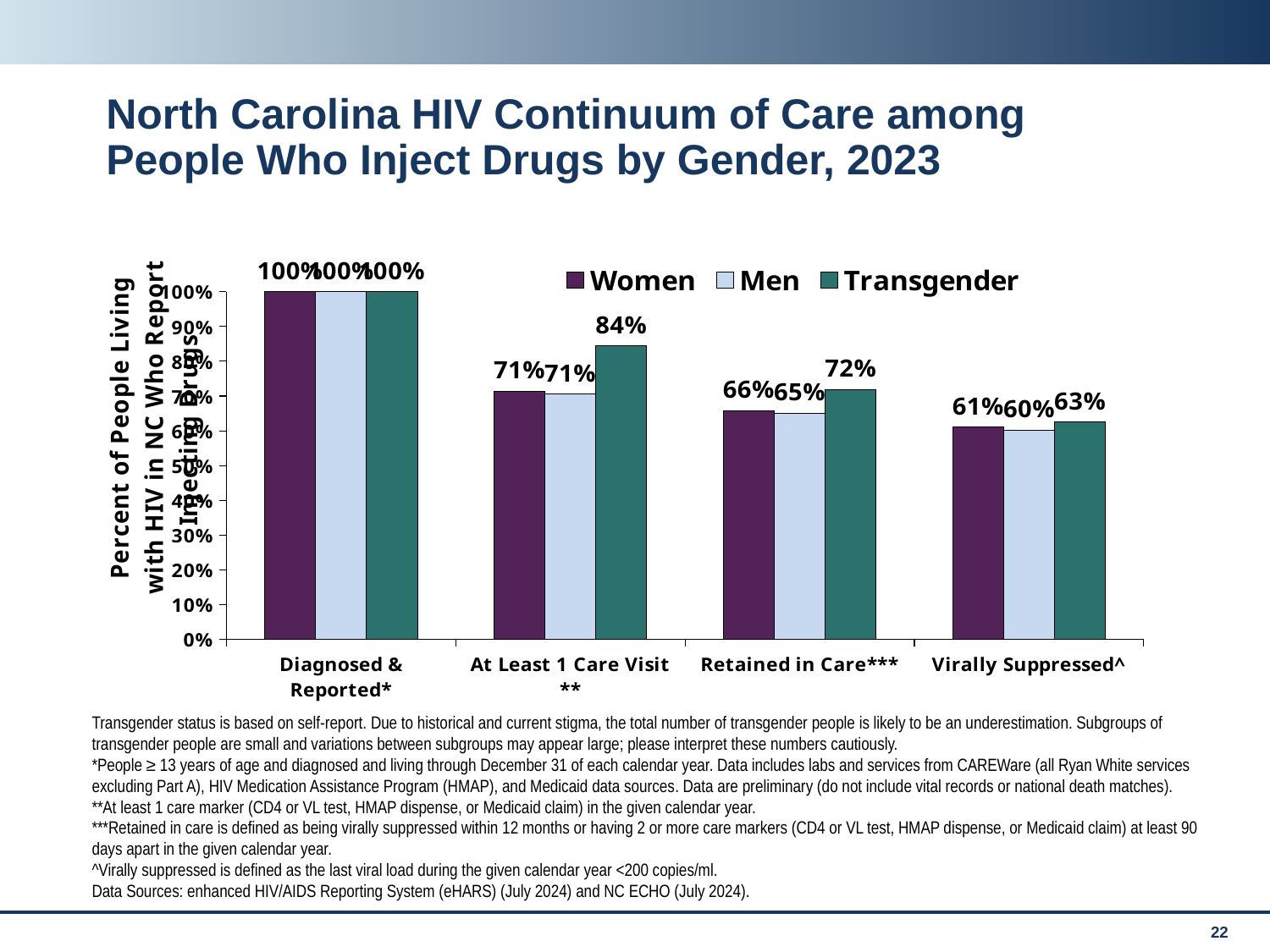
What is the difference between the Transgender and Women values for At Least 1 Care Visit**? 13% What percentage of transgender people who inject drugs had at least 1 care visit? 84% How many categories are shown on the x axis? 4 What is the value for Men in the Virally Suppressed^ category? 60% Do the values for Women rise or fall from Diagnosed & Reported* to Virally Suppressed^? Fall What is the value for Transgender in the Retained in Care*** category? 72% How many series does the legend list? 3 Is the Transgender value for Retained in Care*** larger than the Men value for Retained in Care***? Yes Which gender group has the highest value for At Least 1 Care Visit**? Transgender What is the value for Women in the Retained in Care*** category? 66% Which category has the lowest value for Men? Virally Suppressed^ What kind of chart is shown on the slide? Bar chart